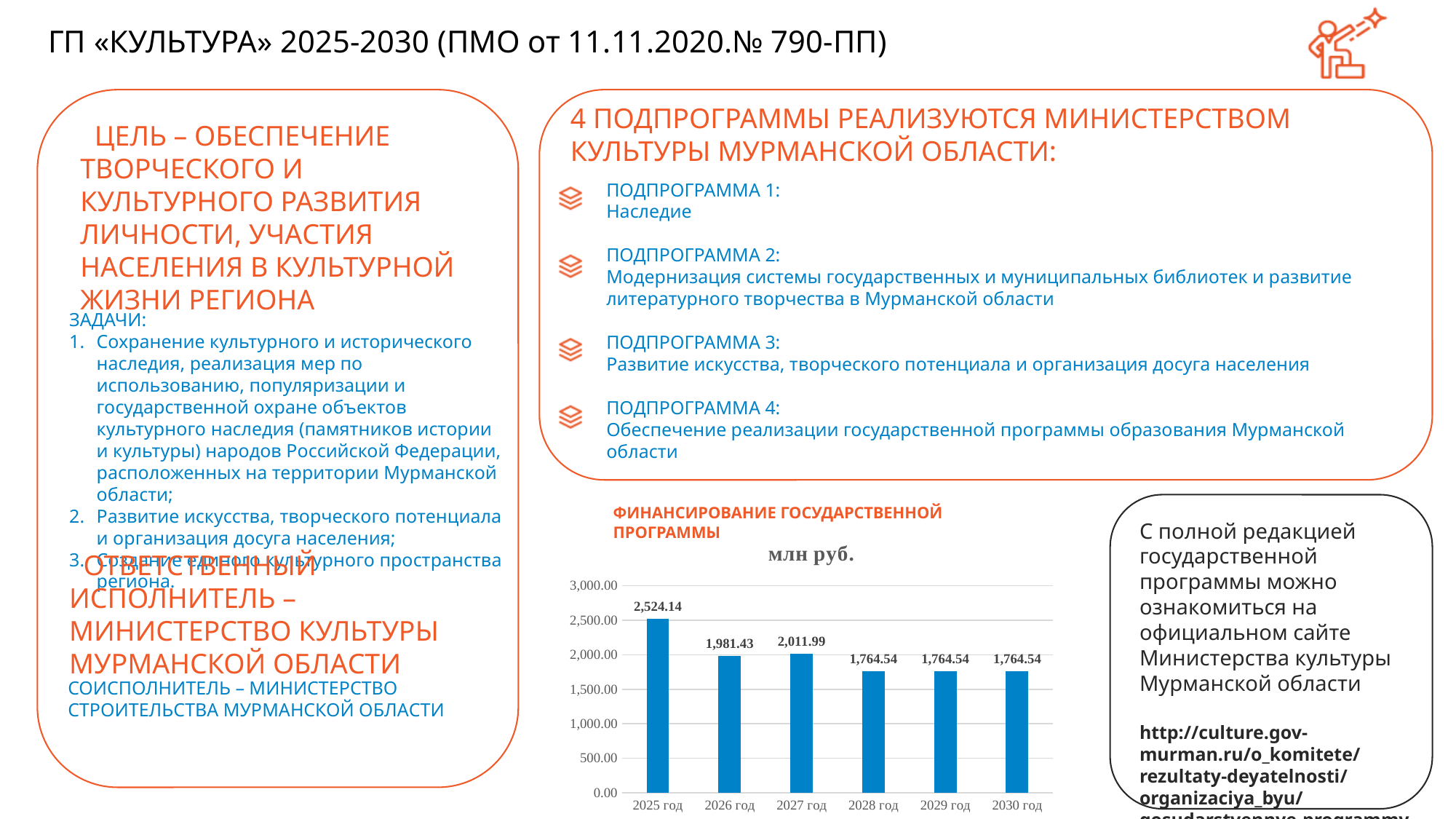
What is the value for 2029 год in the chart? 1,764.54 What is the value for 2027 год in the chart? 2,011.99 What unit is given in the title above the chart? млн руб. What is the value for 2026 год in the chart? 1,981.43 What is the difference between the values for 2027 год and 2028 год? 247.45 Which year has the highest value in the chart? 2025 год What is the difference between the values for 2025 год and 2026 год? 542.71 Which is larger, the value for 2026 год or the value for 2027 год? 2027 год How many years are shown on the x axis of the chart? 6 What is the value for 2025 год in the chart? 2,524.14 What kind of chart is shown on the slide? bar chart Is the value for 2028 год greater or less than 2,000.00? less